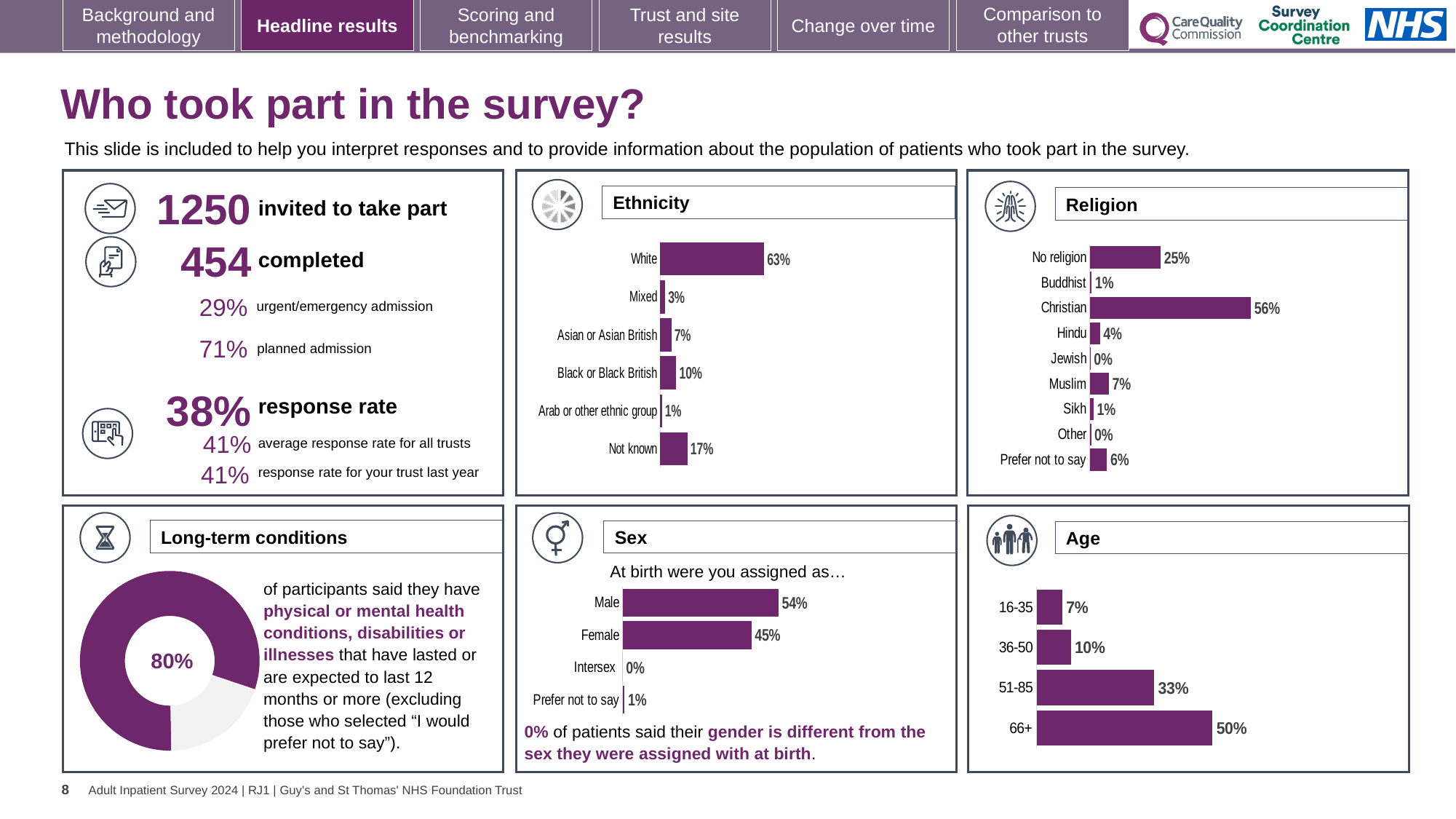
In the Ethnicity chart, which category has the lowest value? Arab or other ethnic group What kind of chart is the Long-term conditions chart? doughnut chart In the Religion chart, which category has the highest value? Christian In the Long-term conditions chart, what share of participants said they have long-term conditions? 80% In the Age chart, what percentage of respondents were aged 51-85? 33% In the Religion chart, what percentage of respondents were Muslim? 7% In the Age chart, do the values rise or fall from 16-35 to 66+? rise How many categories does the Age chart show? 4 In the Sex chart, which is larger, Male or Female? Male In the Sex chart, what is the difference between the Male and Female values? 9% In the Religion chart, what is the difference between the Christian and No religion values? 31% In the Ethnicity chart, what percentage of respondents were White? 63%